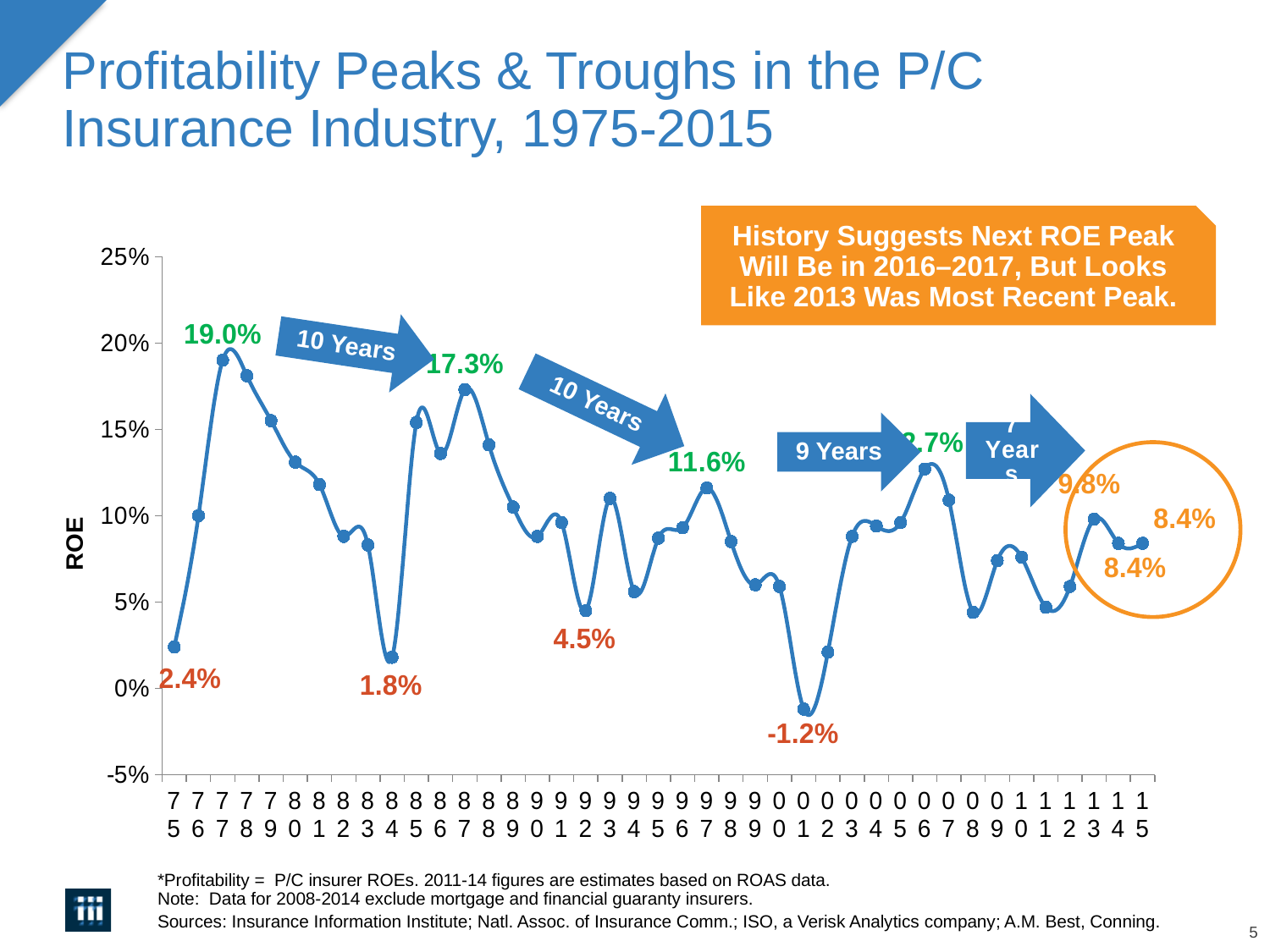
What was the ROE in 2015? 8.4% What was the ROE in 1987? 17.3% What was the ROE in 1997? 11.6% Which year had the lowest ROE? 2001 Is the ROE value for 2013 greater or less than 5%? greater What was the ROE in 1977? 19.0% What was the ROE in 1975? 2.4% What was the ROE in 2001? -1.2% Which year had a higher ROE, 1987 or 1997? 1987 Which year had the highest ROE? 1977 What was the ROE in 1984? 1.8% How much higher was the ROE in 1977 than in 1987? 1.7 percentage points